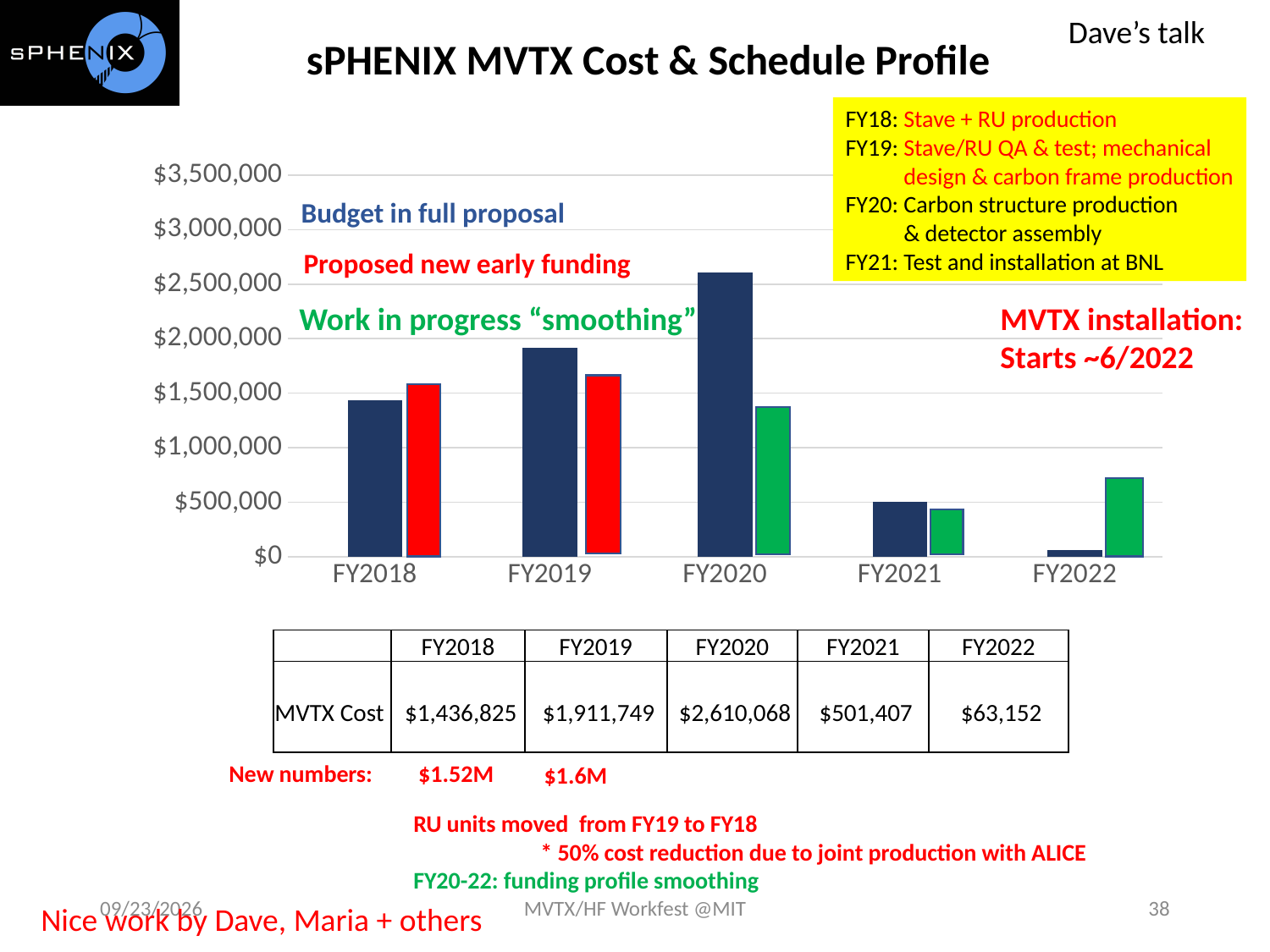
Which is larger, the full proposal budget for FY2018 or for FY2021? FY2018 How many fiscal years are shown on the x axis of the chart? 5 What is the MVTX Cost for FY2018 in the full proposal budget? $1,436,825 What is the MVTX Cost for FY2020 in the full proposal budget? $2,610,068 Which fiscal year has the highest budget in the full proposal? FY2020 What is the title of the slide's chart? sPHENIX MVTX Cost & Schedule Profile What is the MVTX Cost for FY2022 in the full proposal budget? $63,152 Is the 'Work in progress smoothing' value for FY2022 greater or less than $500,000? greater What kind of chart is shown on the slide? bar chart What is the difference between the full proposal budget for FY2020 and FY2019? $698,319 Which fiscal year has the lowest budget in the full proposal? FY2022 Is the 'Work in progress smoothing' value for FY2020 greater or less than $1,500,000? less